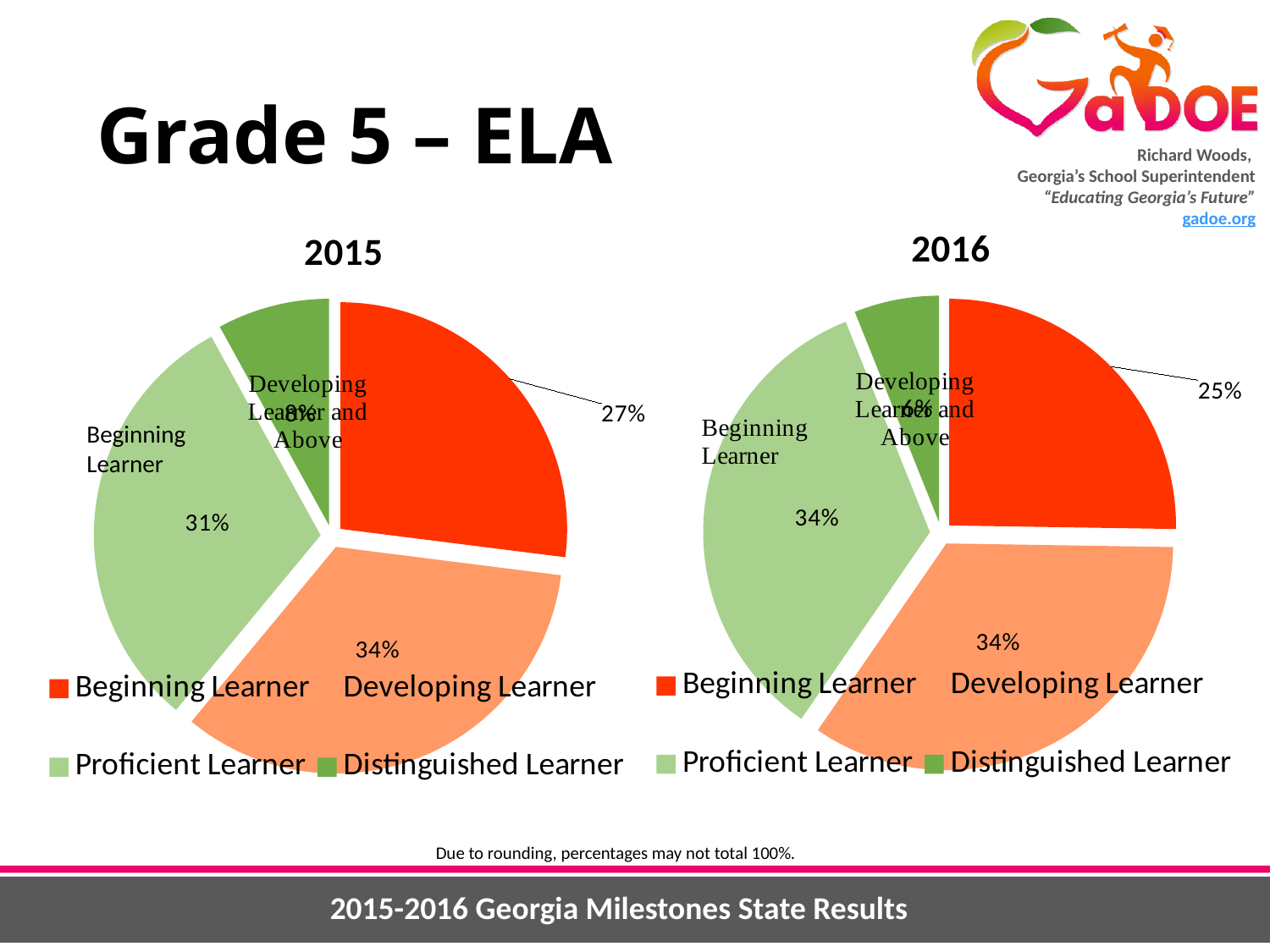
What type of chart is used for the 2016 data? Pie chart In the 2016 pie chart, which category has the smallest share? Distinguished Learner In the 2015 pie chart, which category has the smallest share? Distinguished Learner Which is larger in the 2015 pie chart: the Proficient Learner share or the Beginning Learner share? Proficient Learner In the 2015 pie chart, what percentage is shown for Developing Learner? 34% In the 2016 pie chart, what percentage is shown for Beginning Learner? 25% In the 2015 pie chart, which category has the largest share? Developing Learner In the 2015 pie chart, what percentage is shown for Proficient Learner? 31% In the 2016 pie chart, what percentage is shown for Distinguished Learner? 6% What is the difference between the Beginning Learner percentage in the 2015 chart and in the 2016 chart? 2% In the 2016 pie chart, what percentage is shown for Proficient Learner? 34% In the 2015 pie chart, what percentage is shown for Beginning Learner? 27%